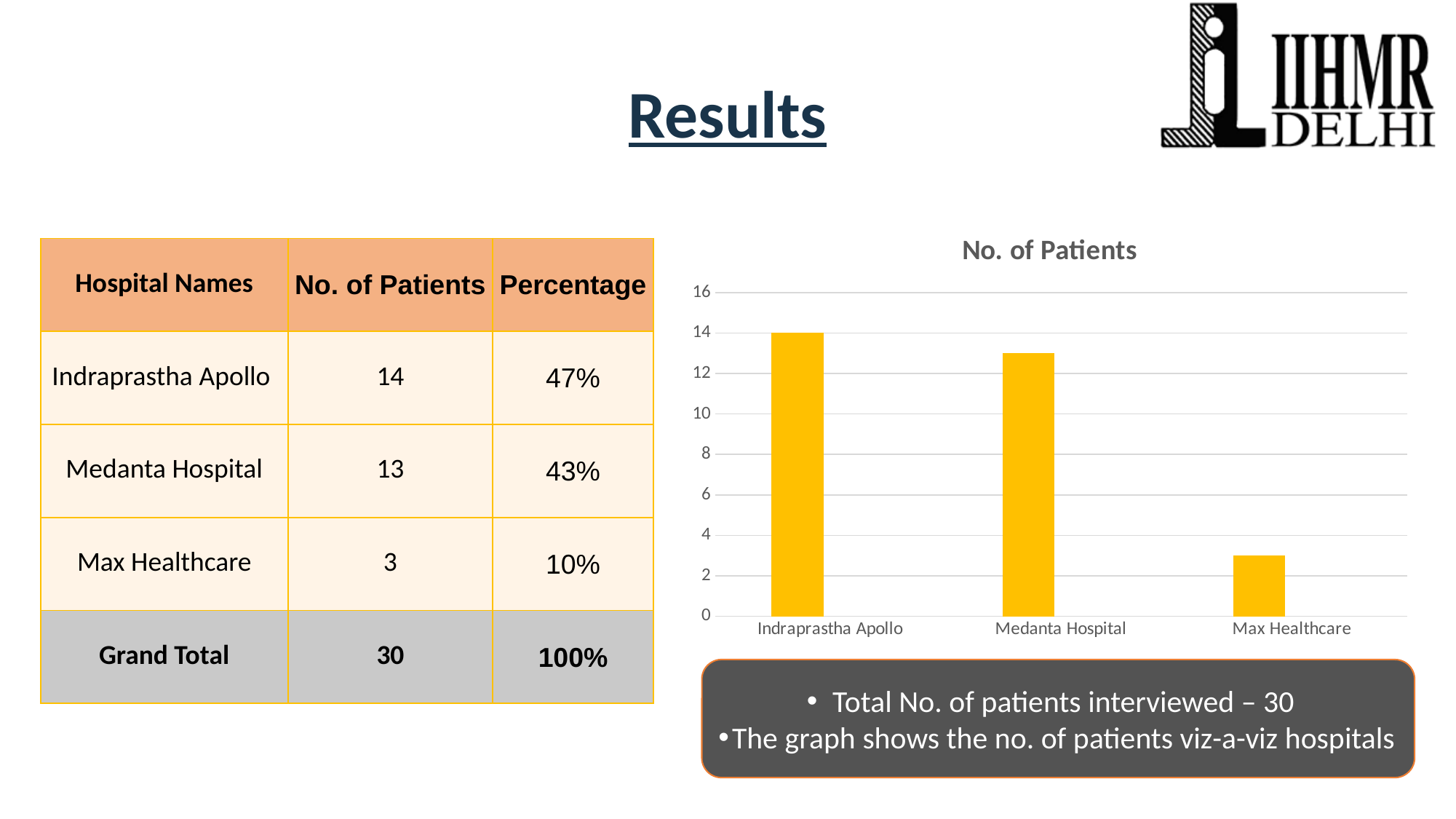
What type of chart is shown on the slide? bar chart What is the difference in number of patients between Indraprastha Apollo and Max Healthcare? 11 What is the number of patients for Medanta Hospital? 13 Which hospital has the lowest number of patients in the chart? Max Healthcare Which hospital has the highest number of patients in the chart? Indraprastha Apollo What is the number of patients for Indraprastha Apollo? 14 How many hospitals are plotted on the chart? 3 What is the title of the chart? No. of Patients Do the bar values rise or fall from left to right across the chart? fall Is the value for Medanta Hospital greater or less than 12? greater What is the number of patients for Max Healthcare? 3 Is the value for Max Healthcare greater or less than 4? less